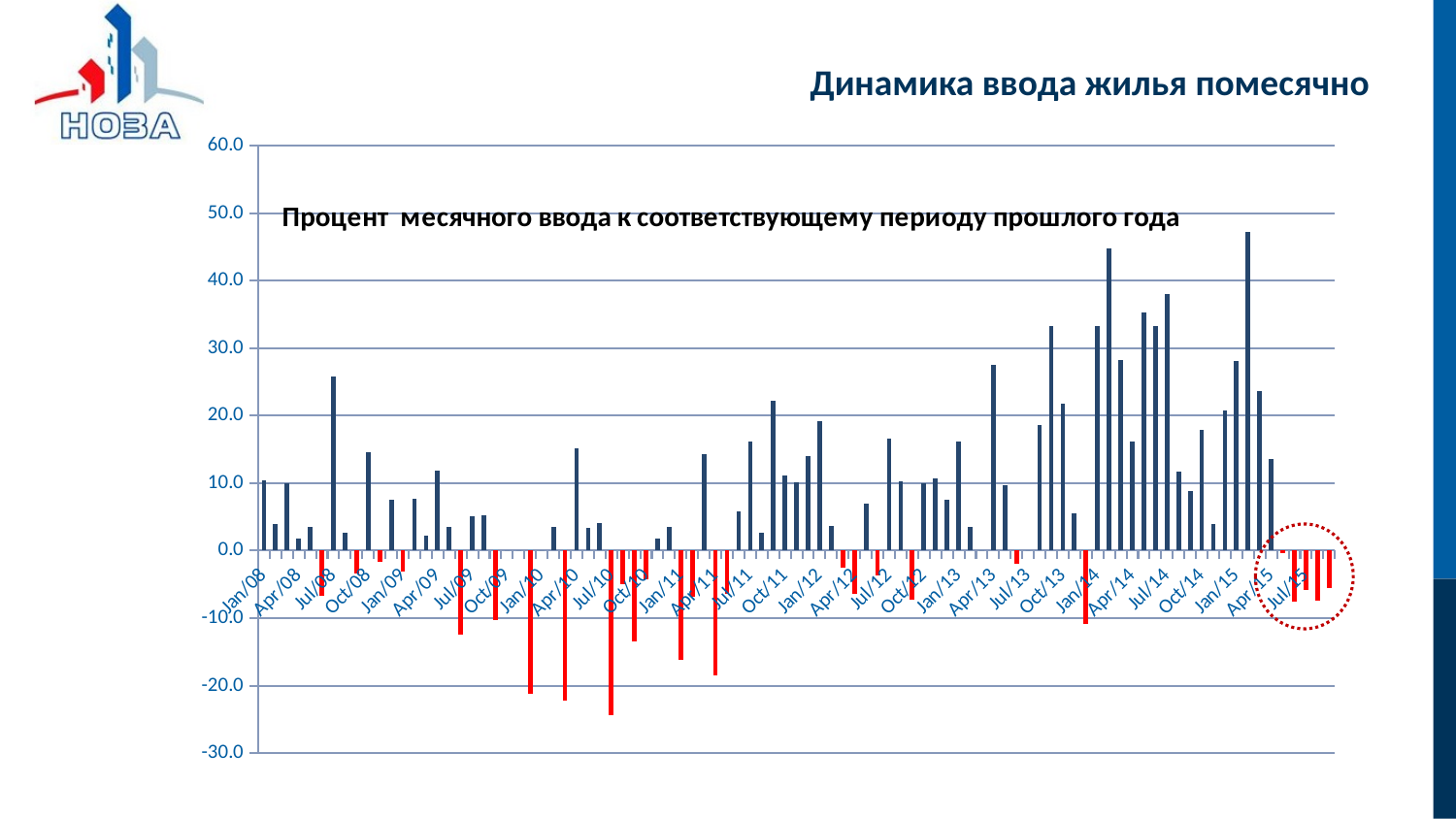
What colour are the bars with negative values? red Is the highest value on the chart greater or less than 50? less Is the lowest value on the chart greater or less than -20? less Is the highest value on the chart greater or less than 40? greater What kind of chart is shown on the slide? bar chart What is the title printed inside the chart area? Процент месячного ввода к соответствующему периоду прошлого года Are the last few bars on the right of the chart (from Jul/15) positive or negative? negative